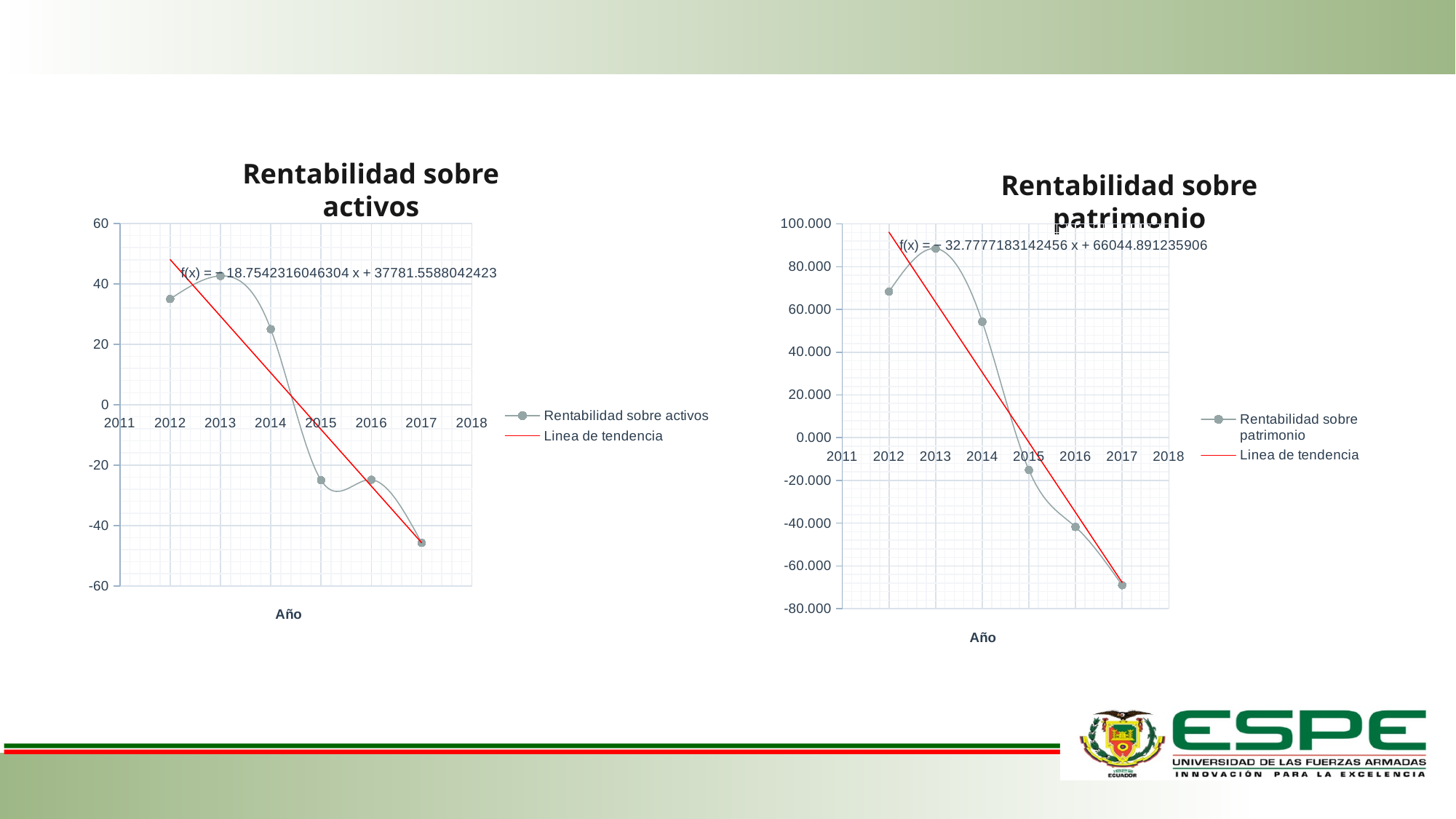
In the 'Rentabilidad sobre patrimonio' chart, which year has the lowest value? 2017 How many entries does the legend of the 'Rentabilidad sobre patrimonio' chart list? 2 In the 'Rentabilidad sobre patrimonio' chart, do the values generally rise or fall from 2013 to 2017? fall In the 'Rentabilidad sobre patrimonio' chart, which year has the highest value? 2013 In the 'Rentabilidad sobre patrimonio' chart, is the value for 2012 greater or less than 60.000? greater In the 'Rentabilidad sobre activos' chart, is the value for 2014 greater or less than 20? greater How many data points are plotted for the 'Rentabilidad sobre activos' series? 6 In the 'Rentabilidad sobre activos' chart, which is larger, the value for 2012 or the value for 2014? 2012 In the 'Rentabilidad sobre activos' chart, is the value for 2017 greater or less than -40? less In the 'Rentabilidad sobre activos' chart, which year has the highest value? 2013 In the 'Rentabilidad sobre activos' chart, which year has the lowest value? 2017 In the 'Rentabilidad sobre patrimonio' chart, which is larger, the value for 2015 or the value for 2016? 2015